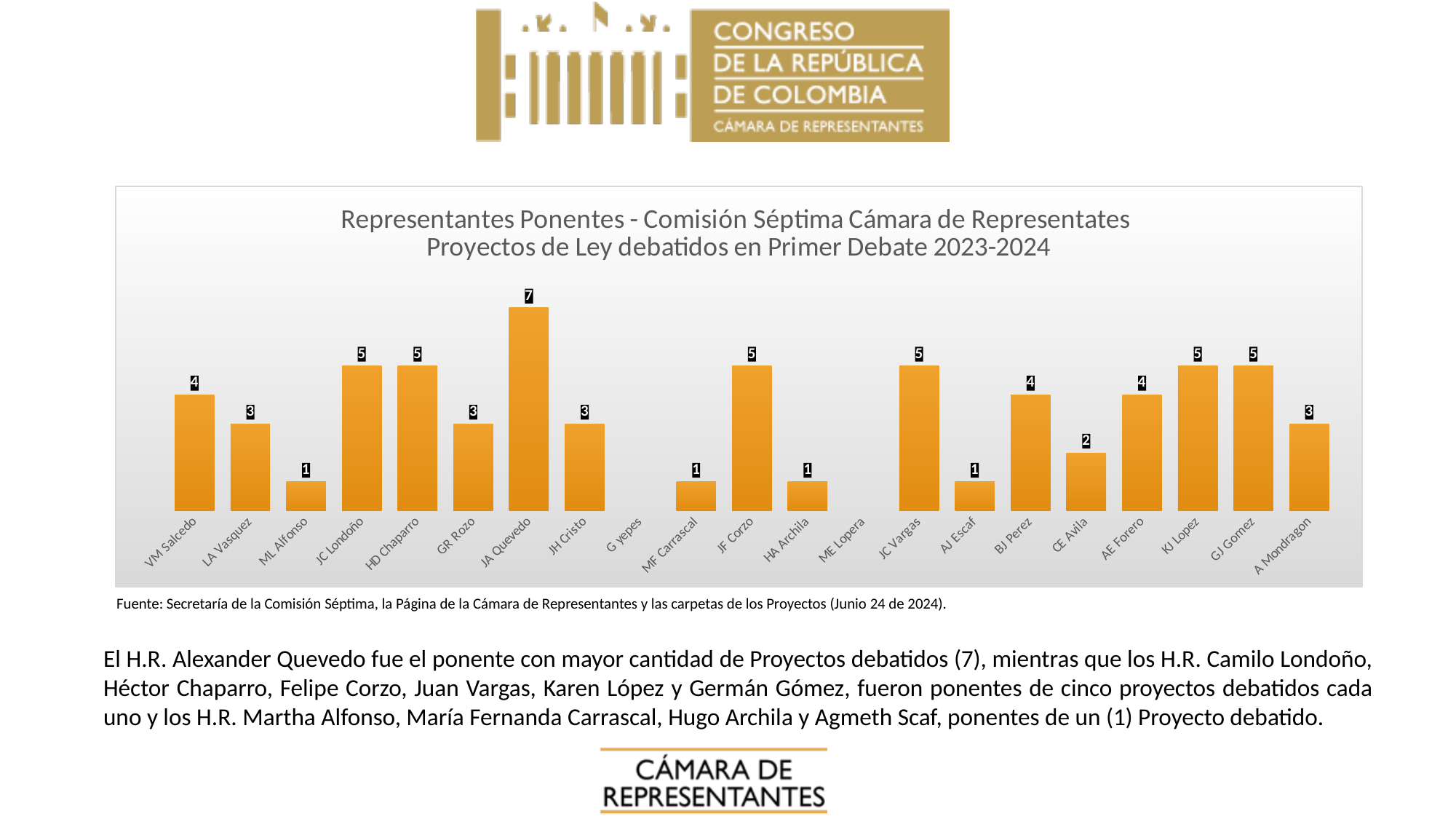
What is the value for A Mondragon? 3 What is the difference between the values for JA Quevedo and JC Londoño? 2 What kind of chart is shown on the slide? Bar chart What is the value for CE Avila? 2 Which is larger, the value for LA Vasquez or the value for HD Chaparro? HD Chaparro What is the value for VM Salcedo? 4 Which is larger, the value for AE Forero or the value for AJ Escaf? AE Forero What is the value for JA Quevedo? 7 Which representative has the highest value? JA Quevedo What is the title of the chart? Representantes Ponentes - Comisión Séptima Cámara de Representates Proyectos de Ley debatidos en Primer Debate 2023-2024 What is the difference between the values for BJ Perez and CE Avila? 2 How many representatives are listed on the x axis? 21